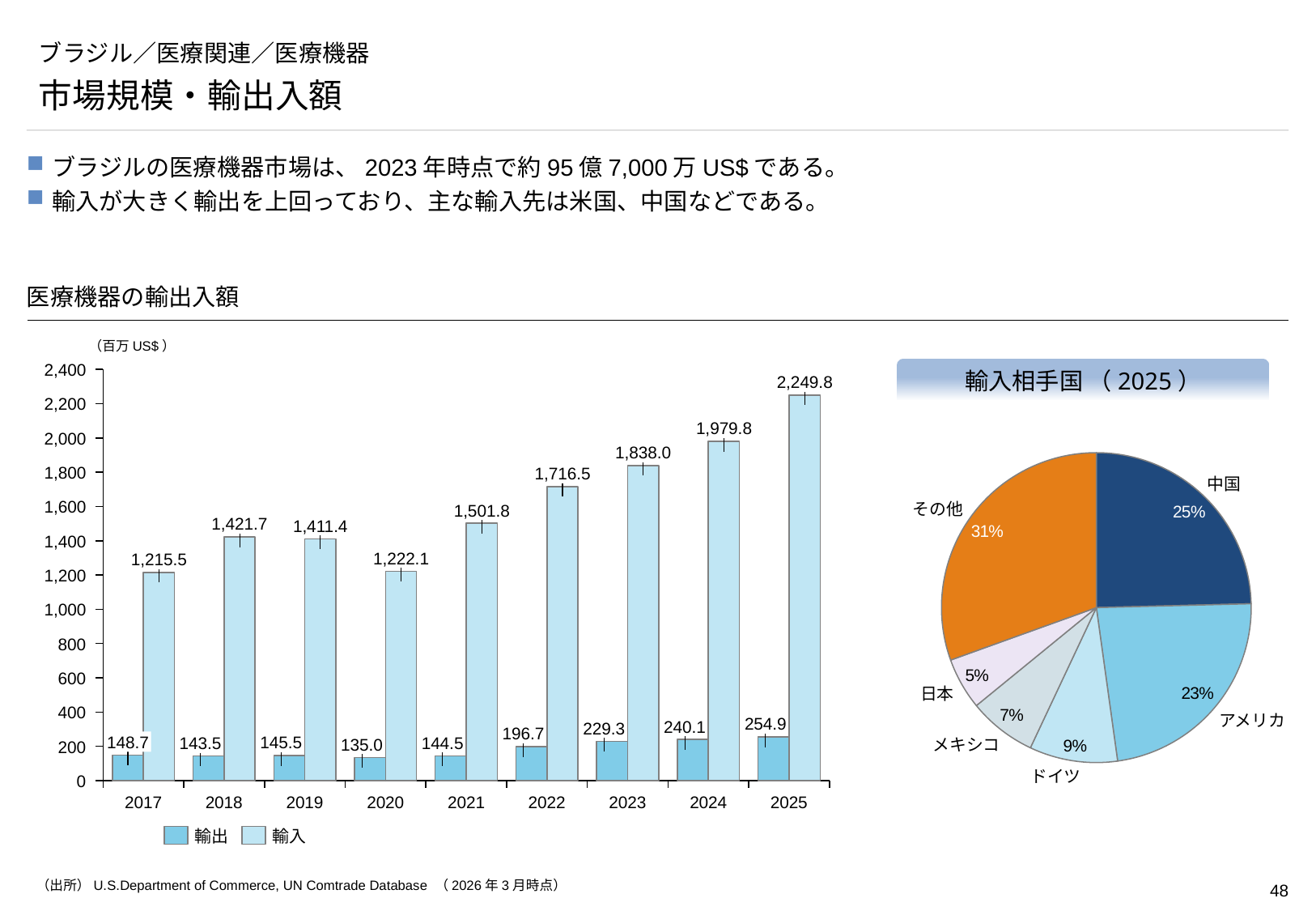
In the bar chart 医療機器の輸出入額, what is the difference between 輸入 and 輸出 in 2023? 1,608.7 In the bar chart 医療機器の輸出入額, which year has the lowest 輸出 value? 2020 In the bar chart 医療機器の輸出入額, is the 輸入 value for 2018 larger than the 輸入 value for 2019? Yes In the bar chart 医療機器の輸出入額, which year has the highest 輸入 value? 2025 In the bar chart 医療機器の輸出入額, does the 輸入 value rise or fall from 2021 to 2025? Rise In the bar chart 医療機器の輸出入額, how many series does the legend list? 2 In the bar chart 医療機器の輸出入額, what is the value of 輸入 for 2025? 2,249.8 What kind of chart is 輸入相手国（2025）? Pie chart In the bar chart 医療機器の輸出入額, what is the value of 輸出 for 2020? 135.0 In the pie chart 輸入相手国（2025）, which named country has the smallest share? 日本 In the pie chart 輸入相手国（2025）, what share does 中国 have? 25% In the bar chart 医療機器の輸出入額, how many years are shown on the x axis? 9